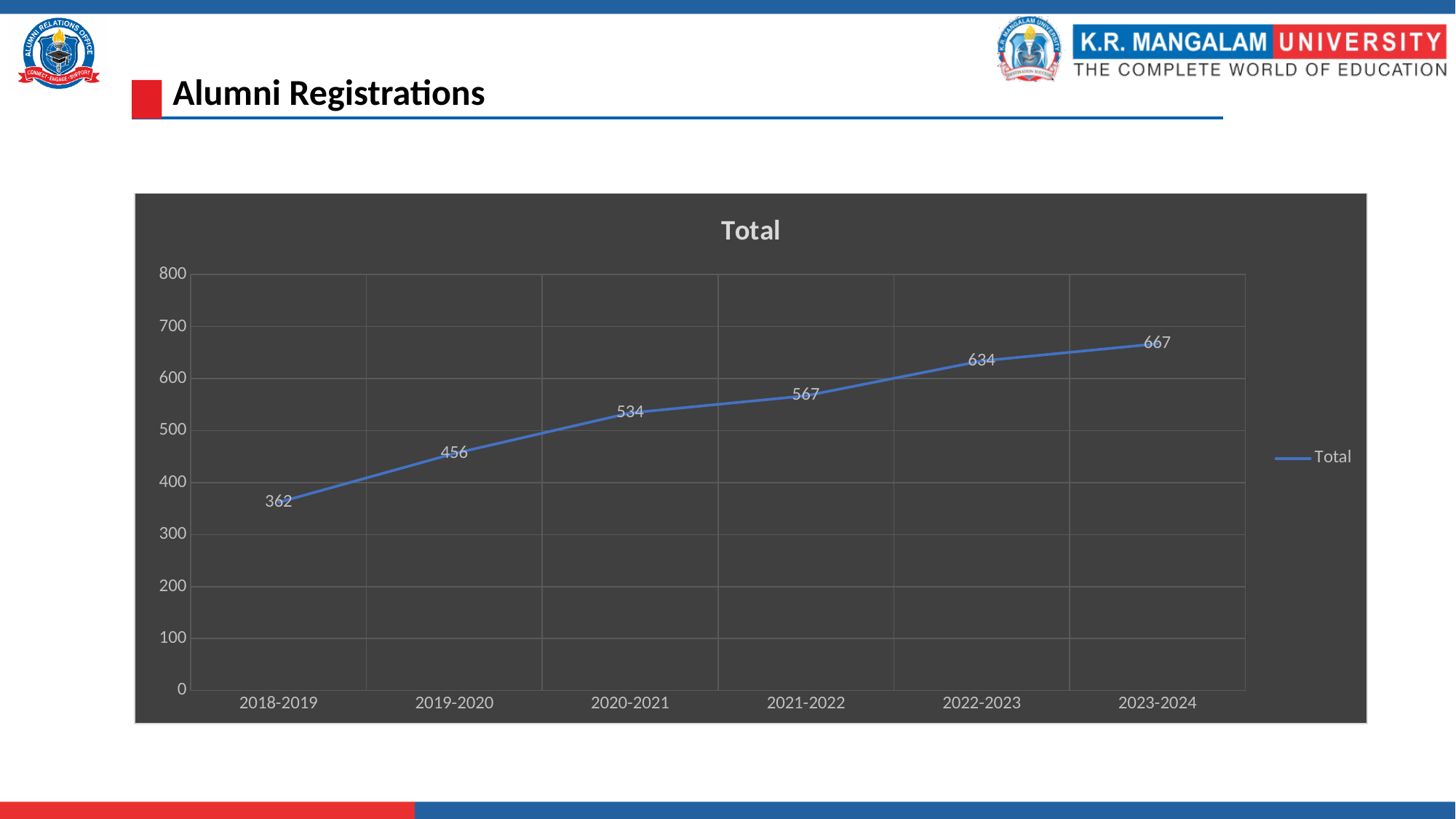
Which is larger, the value for 2022-2023 or the value for 2021-2022? 2022-2023 What is the value for 2023-2024? 667 How many years are plotted on the x axis? 6 What is the value for 2021-2022? 567 Which year has the lowest value? 2018-2019 Is the value for 2019-2020 greater or less than 500? less What is the value for 2018-2019? 362 Do the values rise or fall from 2018-2019 to 2023-2024? rise What is the difference between the values for 2020-2021 and 2019-2020? 78 What is the difference between the values for 2023-2024 and 2018-2019? 305 Which year has the highest value? 2023-2024 What kind of chart is shown? line chart